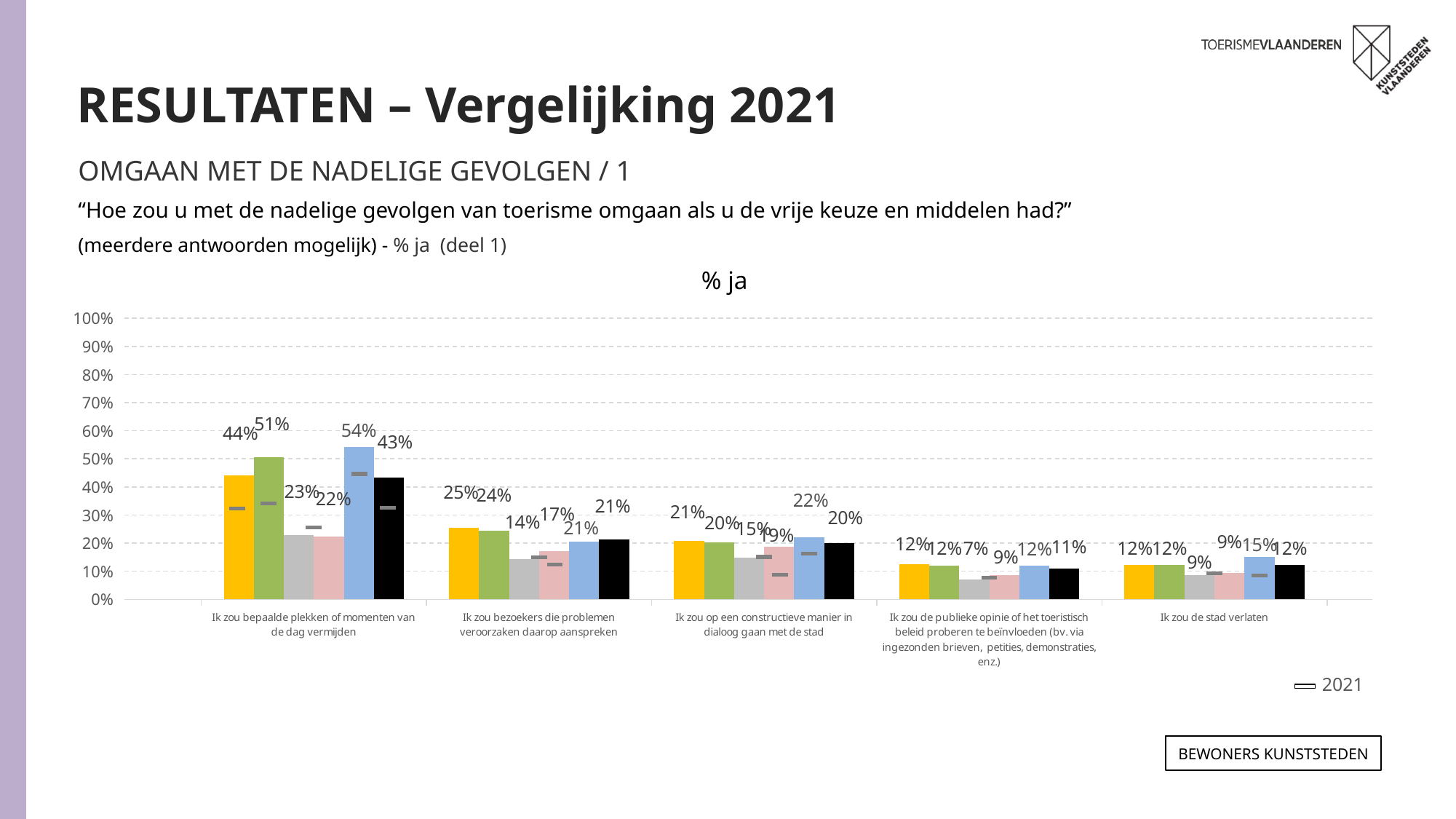
Which category has the highest value across all bars in the chart? Ik zou bepaalde plekken of momenten van de dag vermijden What type of chart is shown on the slide? bar chart What entry does the chart legend list? 2021 What is the value of the blue bar for 'Ik zou bepaalde plekken of momenten van de dag vermijden'? 54% What is the value of the blue bar for 'Ik zou de stad verlaten'? 15% What is the title of the chart? % ja Which is larger for 'Ik zou bezoekers die problemen veroorzaken daarop aanspreken': the grey bar or the pink bar? the pink bar What is the value of the yellow bar for 'Ik zou bezoekers die problemen veroorzaken daarop aanspreken'? 25% Is the value of the green bar for 'Ik zou bepaalde plekken of momenten van de dag vermijden' greater or less than 50%? greater How many categories are shown on the x axis of the chart? 5 What is the difference between the blue bar (54%) and the black bar (43%) for 'Ik zou bepaalde plekken of momenten van de dag vermijden'? 11% What is the value of the grey bar for 'Ik zou de publieke opinie of het toeristisch beleid proberen te beïnvloeden'? 7%